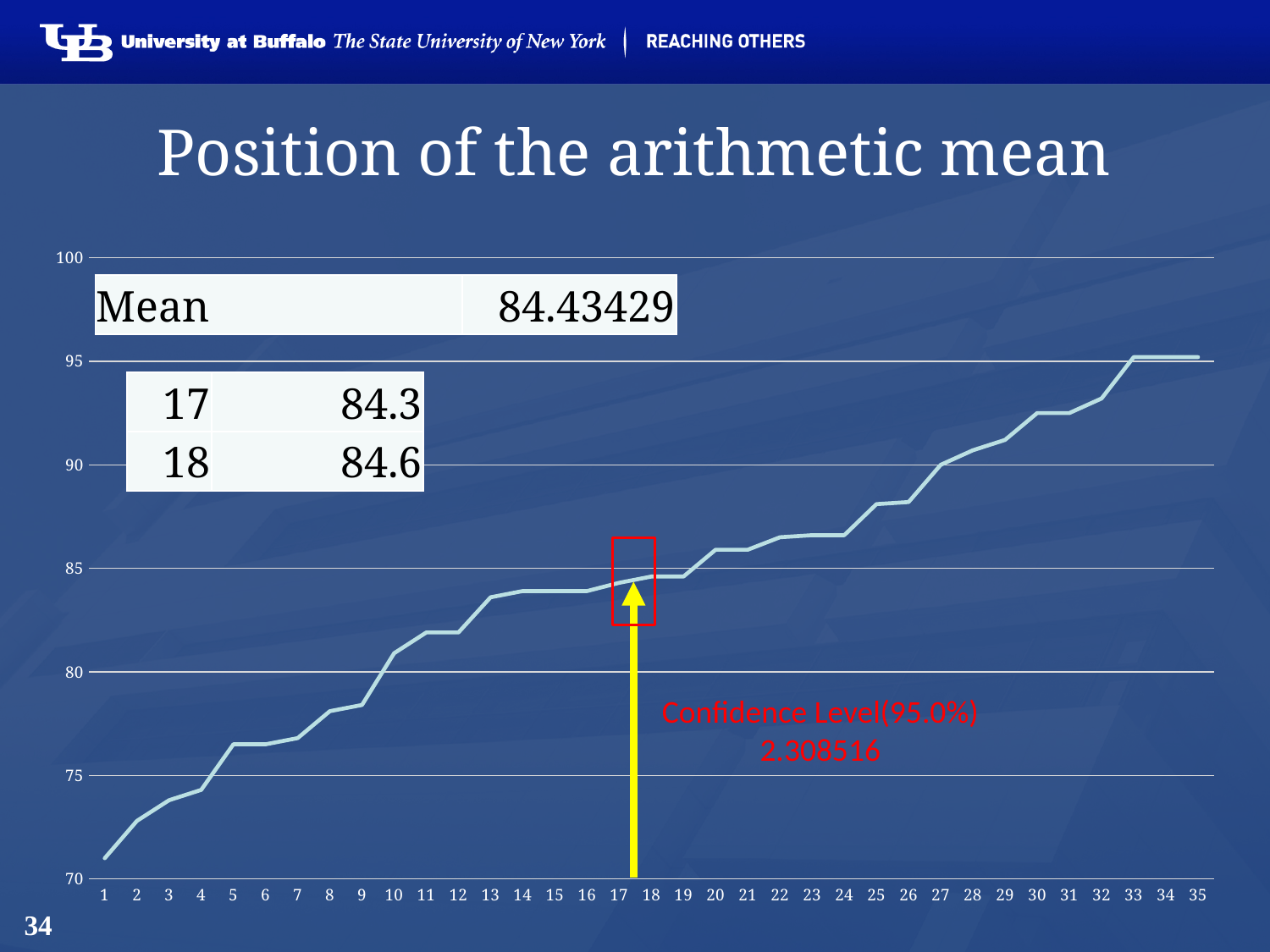
What is the value shown for position 17? 84.3 Is the value for position 1 greater or less than 75? less How many points are plotted along the x axis of the chart? 35 What mean value is shown on the slide? 84.43429 What is the value shown for position 18? 84.6 Do the plotted values rise or fall as the x axis goes from 1 to 35? rise What kind of chart is shown on the slide? line chart What is the difference between the values at positions 18 and 17? 0.3 Is the value for position 20 greater or less than 85? greater Which position has the lowest value on the chart? 1 Which has the larger value, position 17 or position 18? 18 What Confidence Level(95.0%) value is shown on the chart? 2.308516